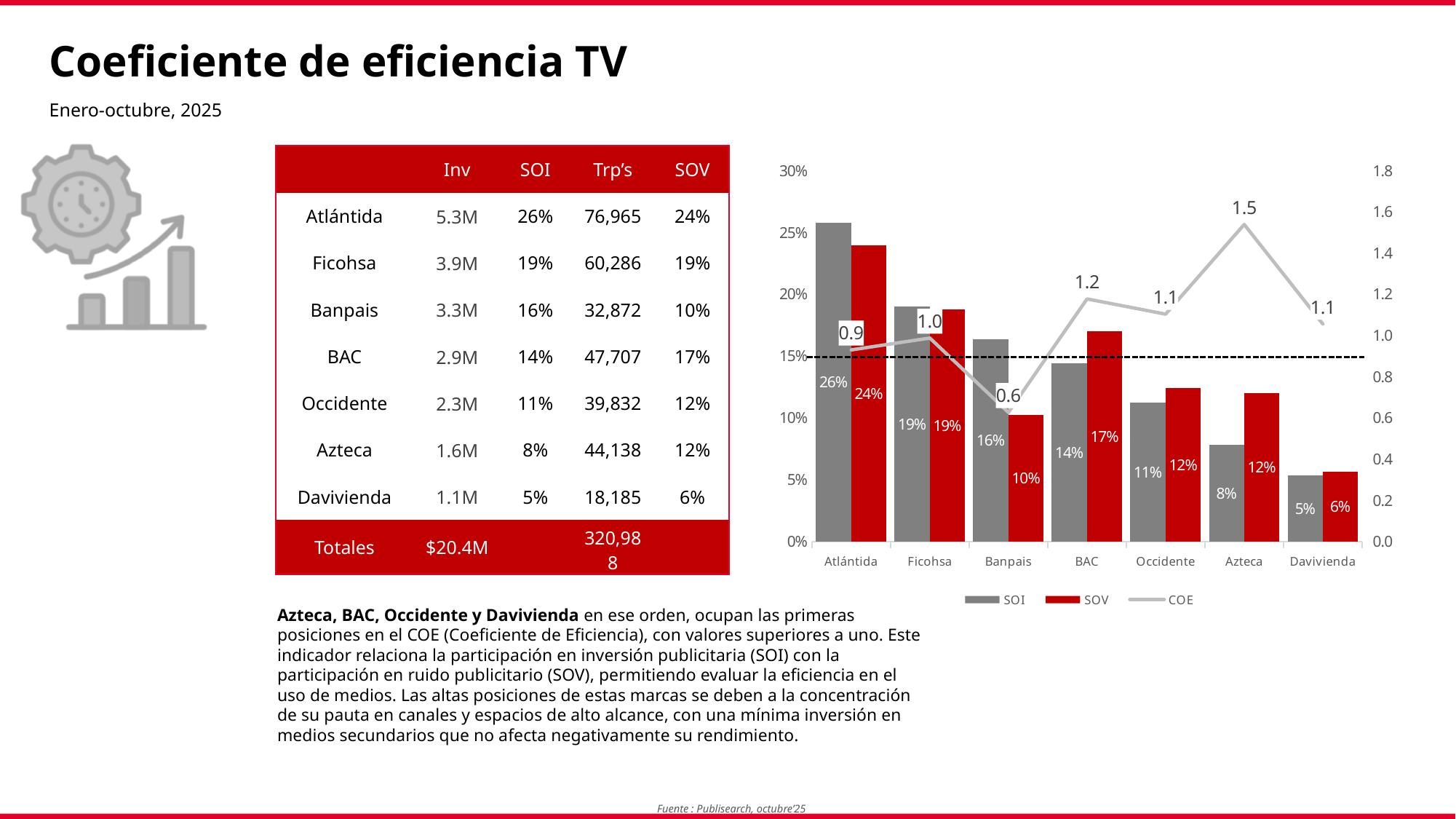
Which category has the lowest SOV value? Davivienda Which category has the highest COE value? Azteca What is the COE value for Azteca? 1.5 How many series does the legend list? 3 Which series is plotted as a line in the chart? COE What is the SOV value for BAC? 17% Which is larger for Occidente, SOI or SOV? SOV What is the difference between the SOI and SOV values for Banpais? 6% Do the SOI values rise or fall from Atlántida to Davivienda? Fall What is the SOI value for Atlántida? 26% How many categories are shown on the x axis? 7 What kind of chart is shown on the slide? Combined bar and line chart